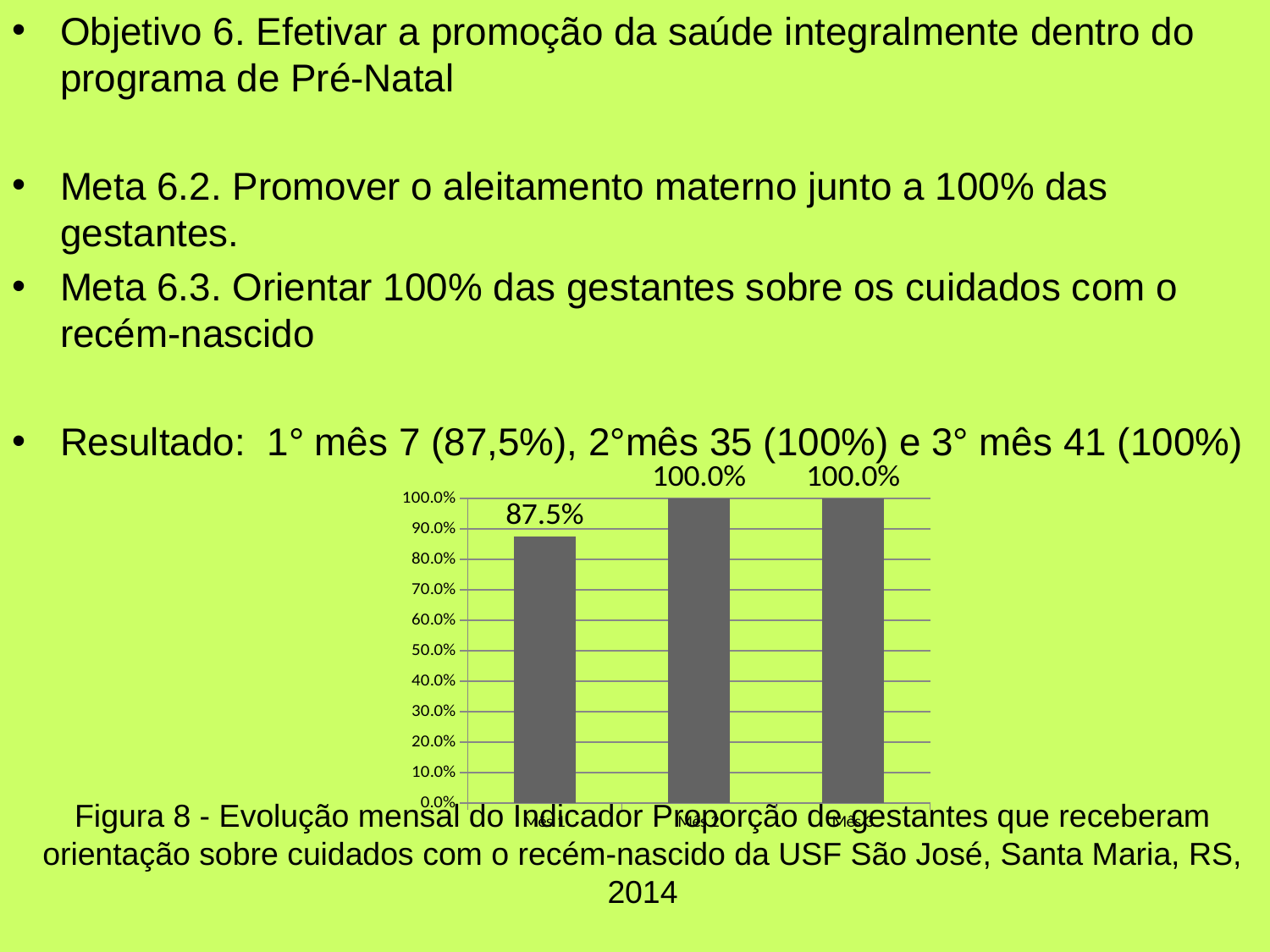
Is the value for the first bar greater or less than 80.0%? greater What colour are the bars in the chart? Grey Which bar in the chart has the lowest value? The first bar (Mês 1) What is the value shown for the third bar in the chart? 100.0% Which is larger, the value of the first bar or the value of the second bar? The second bar What is the difference between the value of the second bar and the value of the first bar? 12.5% What is the value shown for the second bar in the chart? 100.0% What kind of chart is shown on the slide? Bar chart How many bars are plotted in the chart? 3 What is the value shown for the first bar in the chart? 87.5% Do the values rise or fall from the first bar to the third bar? Rise What is the highest tick value shown on the y axis of the chart? 100.0%